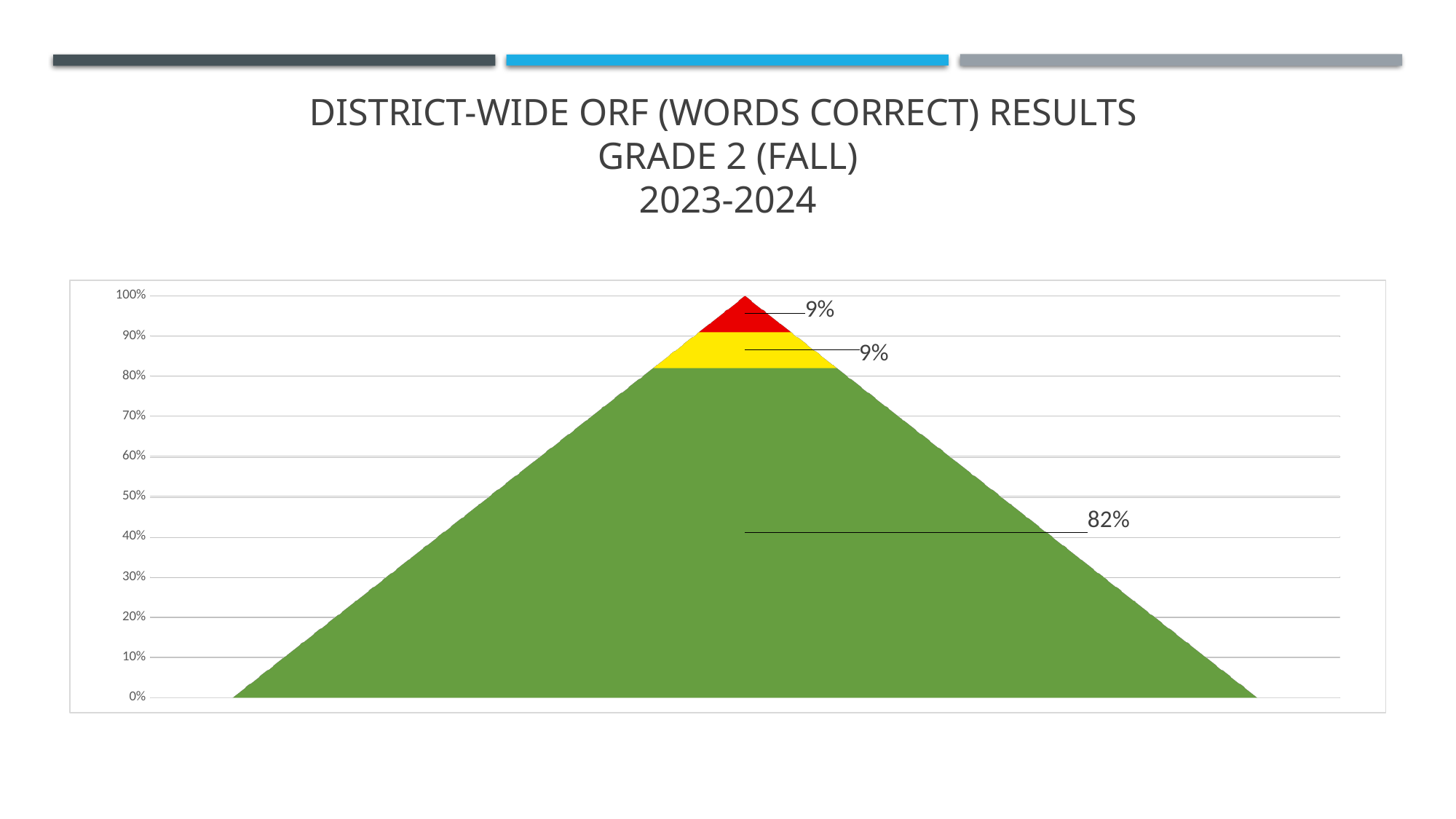
What is the difference between the green segment's value and the red segment's value? 73 percentage points How many segments make up the pyramid? 3 What kind of chart is shown on the slide? Stacked pyramid chart What value is labelled on the green segment of the pyramid? 82% What grade and season does the chart title refer to? Grade 2 (Fall) What is the total of all the labelled segments in the pyramid? 100% Is the value for the green segment greater or less than 50%? greater Which is larger, the green segment's value or the yellow segment's value? Green What value is labelled on the red segment at the top of the pyramid? 9% What value is labelled on the yellow segment of the pyramid? 9% Which coloured segment has the largest value? Green Is the value for the red segment greater or less than 20%? less